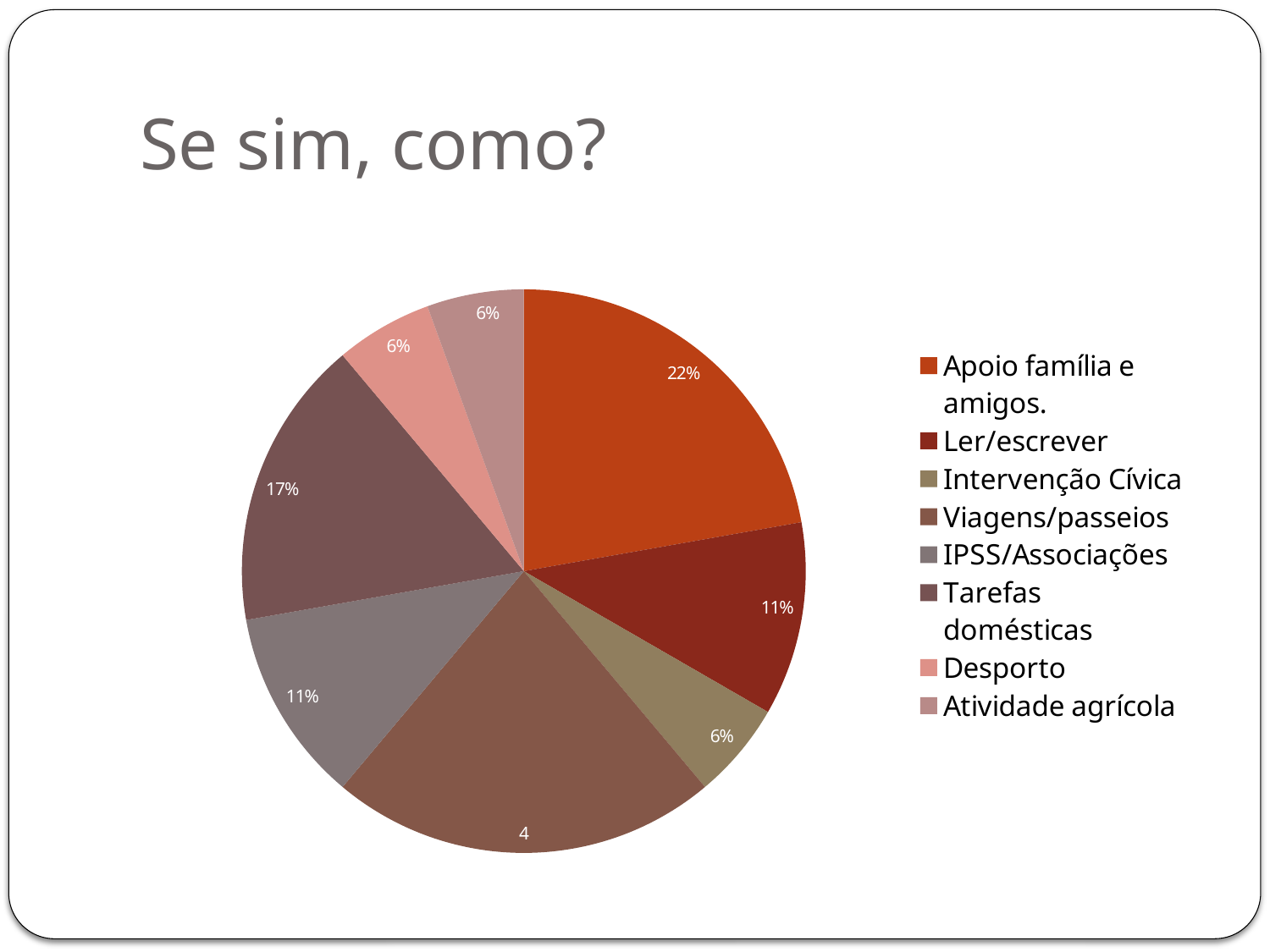
What label is printed on the Viagens/passeios slice? 4 What is the title of the slide? Se sim, como? How many categories does the pie chart have? 8 What percentage is shown for Ler/escrever? 11% Which is larger, the share for Apoio família e amigos or the share for Intervenção Cívica? Apoio família e amigos What kind of chart is shown on the slide? Pie chart What percentage of the pie is labelled for Apoio família e amigos? 22% What is the difference in percentage points between Apoio família e amigos and IPSS/Associações? 11 Which is larger, the share for Tarefas domésticas or the share for Ler/escrever? Tarefas domésticas What percentage is shown for IPSS/Associações? 11% What percentage is shown for Tarefas domésticas? 17% What percentage is shown for Desporto? 6%